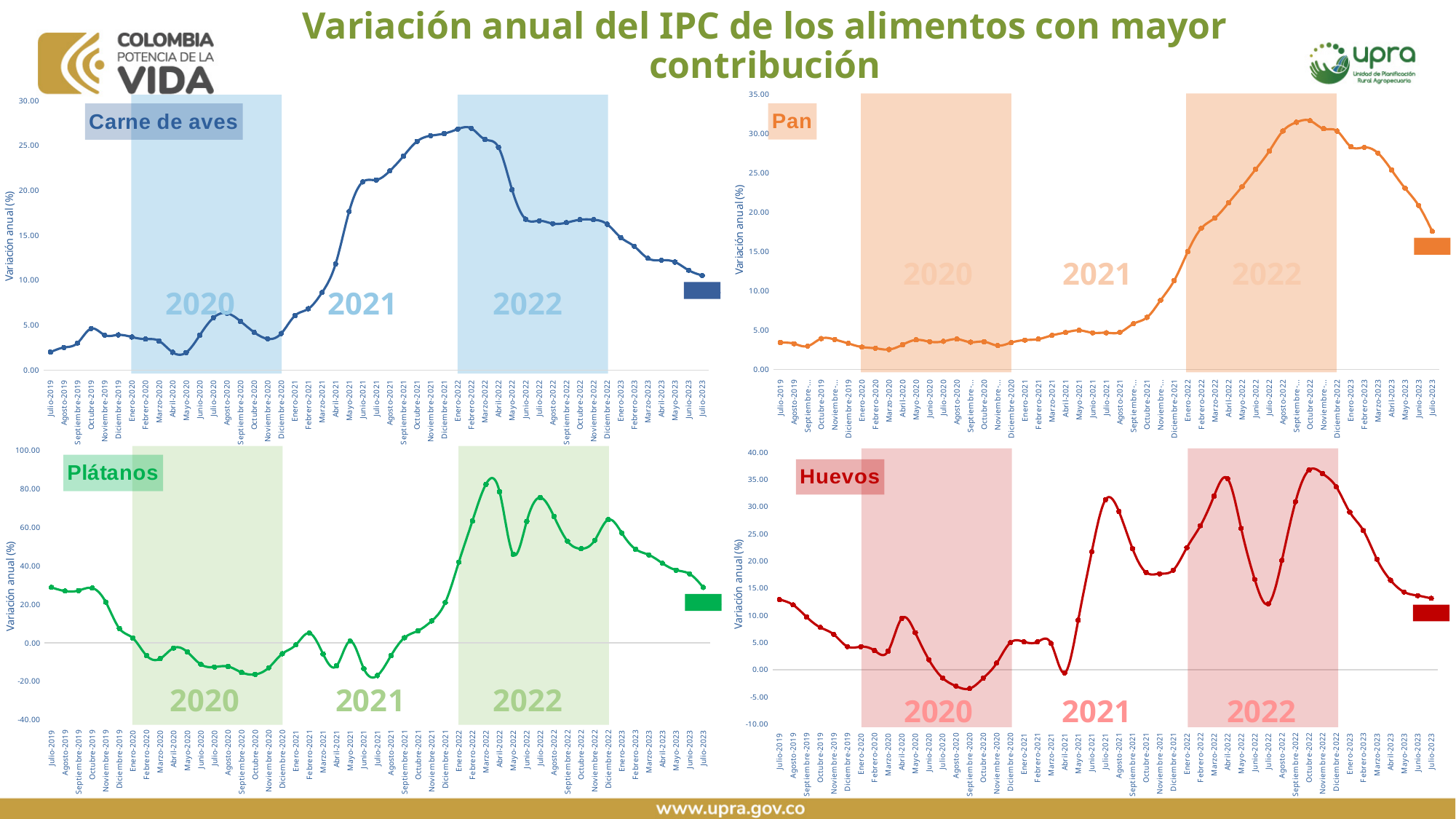
How many charts are shown on the slide? 4 In the Pan chart, which is larger, the value for Julio-2019 or the value for Julio-2023? Julio-2023 In the Carne de aves chart, is the value for Julio-2023 greater or less than 15.00? less Which of the four charts is drawn with a red line? Huevos In the Pan chart, is the value for Octubre-2022 greater or less than 30.00? greater In the Carne de aves chart, do the values rise or fall from Febrero-2022 to Julio-2023? fall In the Pan chart, do the values rise or fall from Enero-2022 to Octubre-2022? rise In the Plátanos chart, which month has the highest value? Marzo-2022 In the Huevos chart, is the value for Julio-2021 greater or less than 25.00? greater What kind of chart is the Carne de aves chart? Line chart